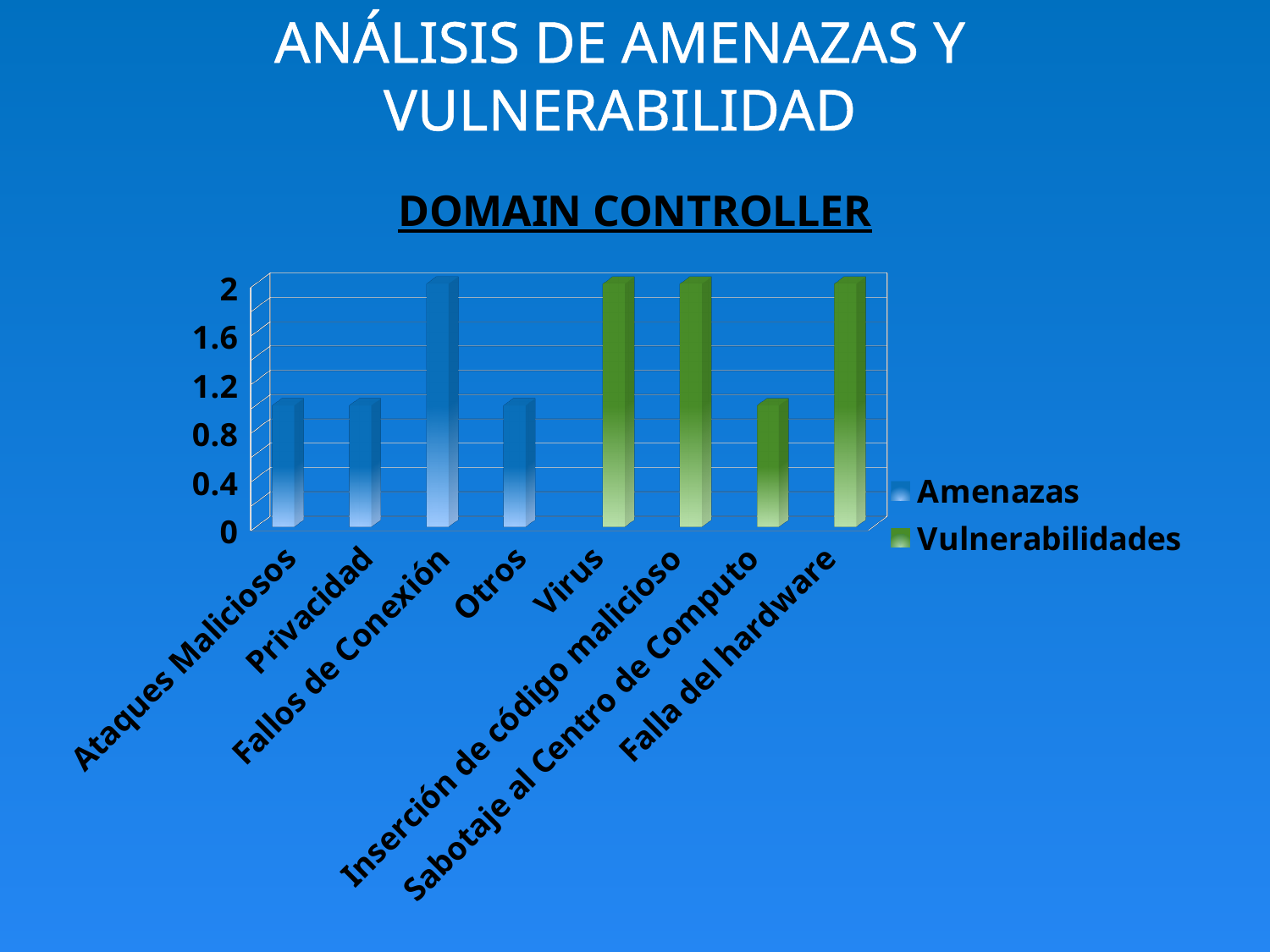
What is the value for Fallos de Conexión? 2 What kind of chart is shown on the slide? Bar chart How many series does the chart's legend list? 2 Which is larger, the value for Fallos de Conexión or the value for Otros? Fallos de Conexión Which category in the Vulnerabilidades series has the lowest value? Sabotaje al Centro de Computo What is the value for Virus? 2 Is the value for Privacidad greater or less than 0.8? greater How many categories are shown on the x axis of the chart? 8 Is the value for Ataques Maliciosos greater or less than 1.2? less Is the value for Sabotaje al Centro de Computo greater or less than 1.2? less Which category in the Amenazas series has the highest value? Fallos de Conexión What is the title of the chart? DOMAIN CONTROLLER